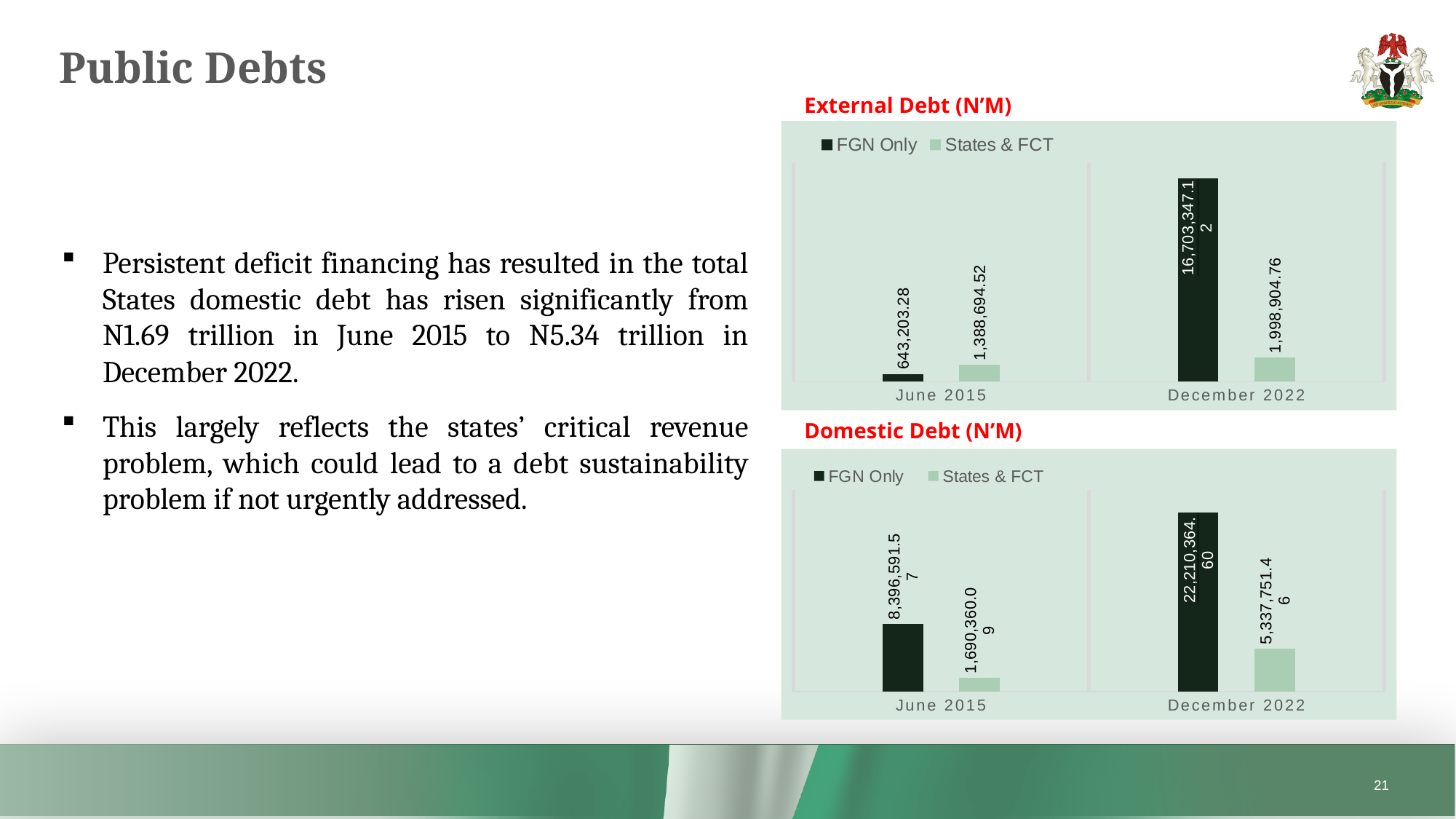
In the External Debt (N'M) chart, what is the value for States & FCT in December 2022? 1,998,904.76 In the External Debt (N'M) chart, which bar is the highest? FGN Only, December 2022 In the External Debt (N'M) chart, which is larger in June 2015: FGN Only or States & FCT? States & FCT In the Domestic Debt (N'M) chart, what is the value for FGN Only in December 2022? 22,210,364.60 In the External Debt (N'M) chart, what is the value for FGN Only in June 2015? 643,203.28 What kind of chart is the Domestic Debt (N'M) chart? Bar chart In the Domestic Debt (N'M) chart, what is the difference between the States & FCT values for December 2022 and June 2015? 3,647,391.37 In the Domestic Debt (N'M) chart, what is the value for States & FCT in June 2015? 1,690,360.09 How many categories are shown on the x axis of the External Debt (N'M) chart? 2 In the Domestic Debt (N'M) chart, which bar is the lowest? States & FCT, June 2015 In the Domestic Debt (N'M) chart, does the States & FCT value rise or fall from June 2015 to December 2022? Rise How many series does the legend of the Domestic Debt (N'M) chart list? 2